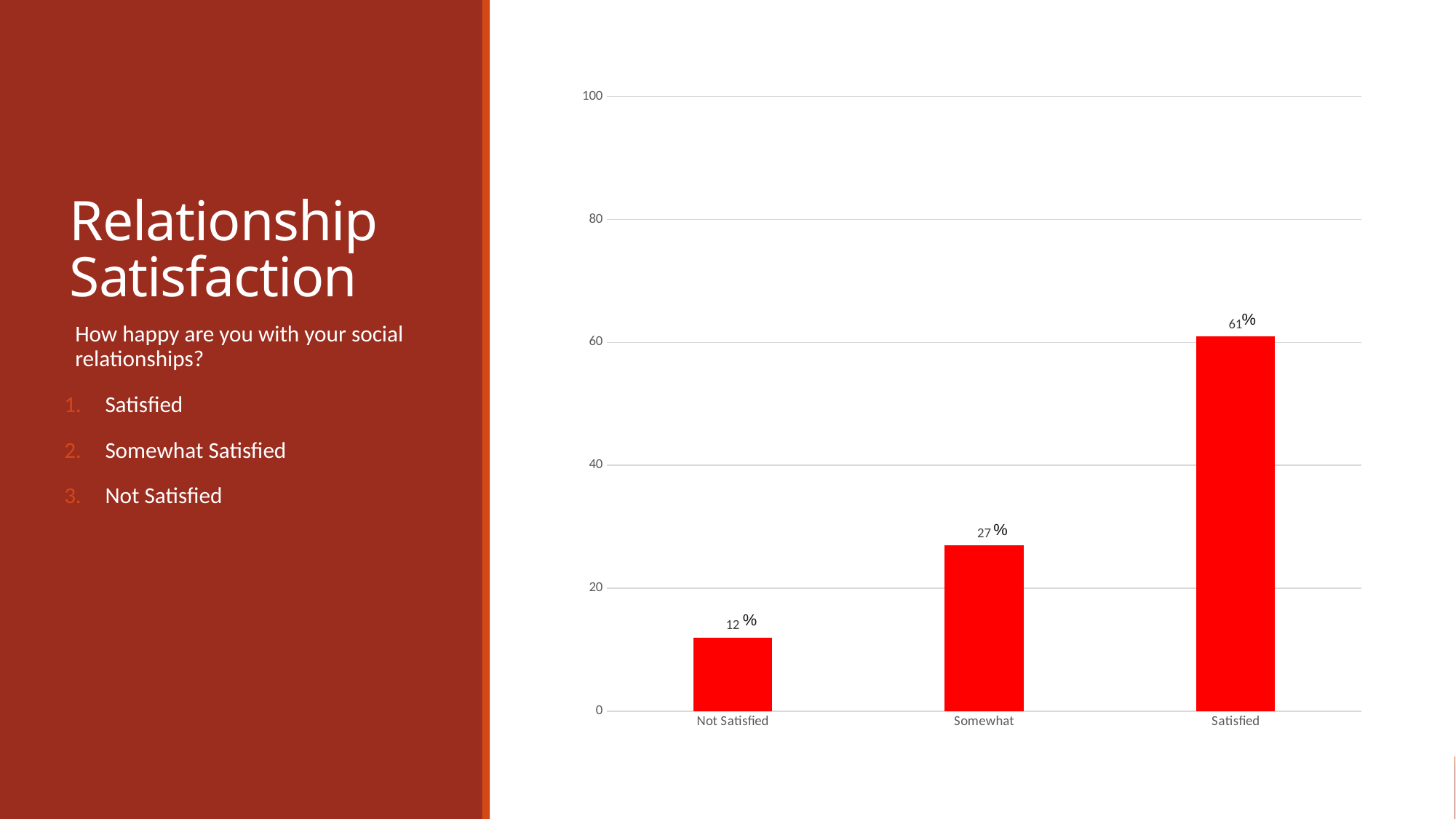
What kind of chart is shown on the slide? bar chart What is the difference between the values for Somewhat and Not Satisfied? 15% Which category has the highest value? Satisfied Which is larger, the value for Somewhat or the value for Satisfied? Satisfied What is the difference between the values for Satisfied and Not Satisfied? 49% How many categories are shown on the x axis? 3 Which category has the lowest value? Not Satisfied What is the value for Somewhat? 27% What is the value for Satisfied? 61% Is the value for Satisfied greater or less than 60? greater Do the values rise or fall from left to right along the x axis? rise What is the value for Not Satisfied? 12%